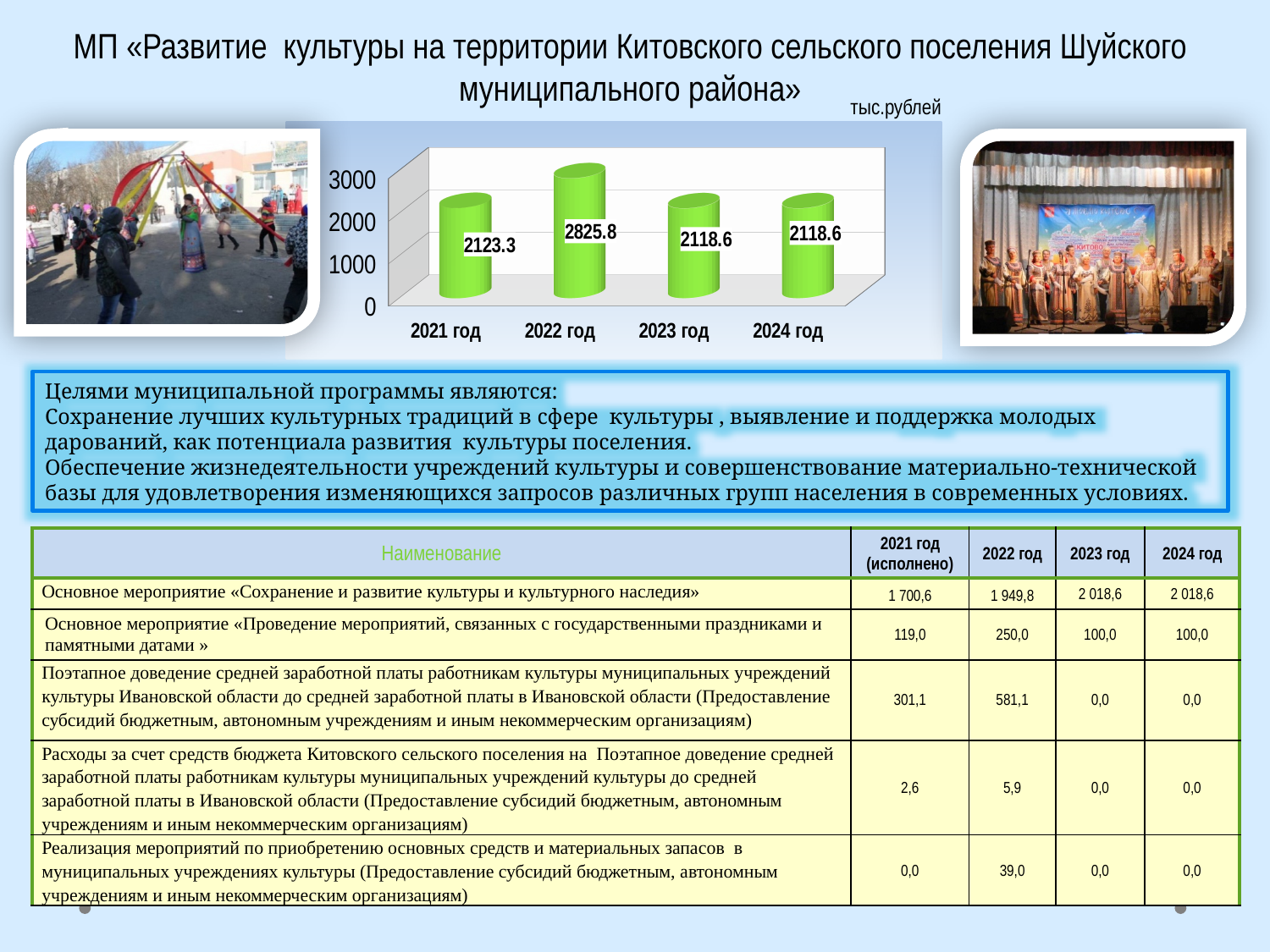
What is the value for 2024 год? 2118.6 What is the value for 2023 год? 2118.6 What is the value for 2021 год? 2123.3 What is the value for 2022 год? 2825.8 What kind of chart is shown on the slide? bar chart Which year has the highest value? 2022 год What unit is indicated above the chart? тыс.рублей What is the difference between the values for 2021 год and 2023 год? 4.7 Is the value for 2022 год greater or less than 2000? greater What is the difference between the values for 2022 год and 2021 год? 702.5 Which is larger, the value for 2022 год or the value for 2024 год? 2022 год How many years are shown on the chart? 4